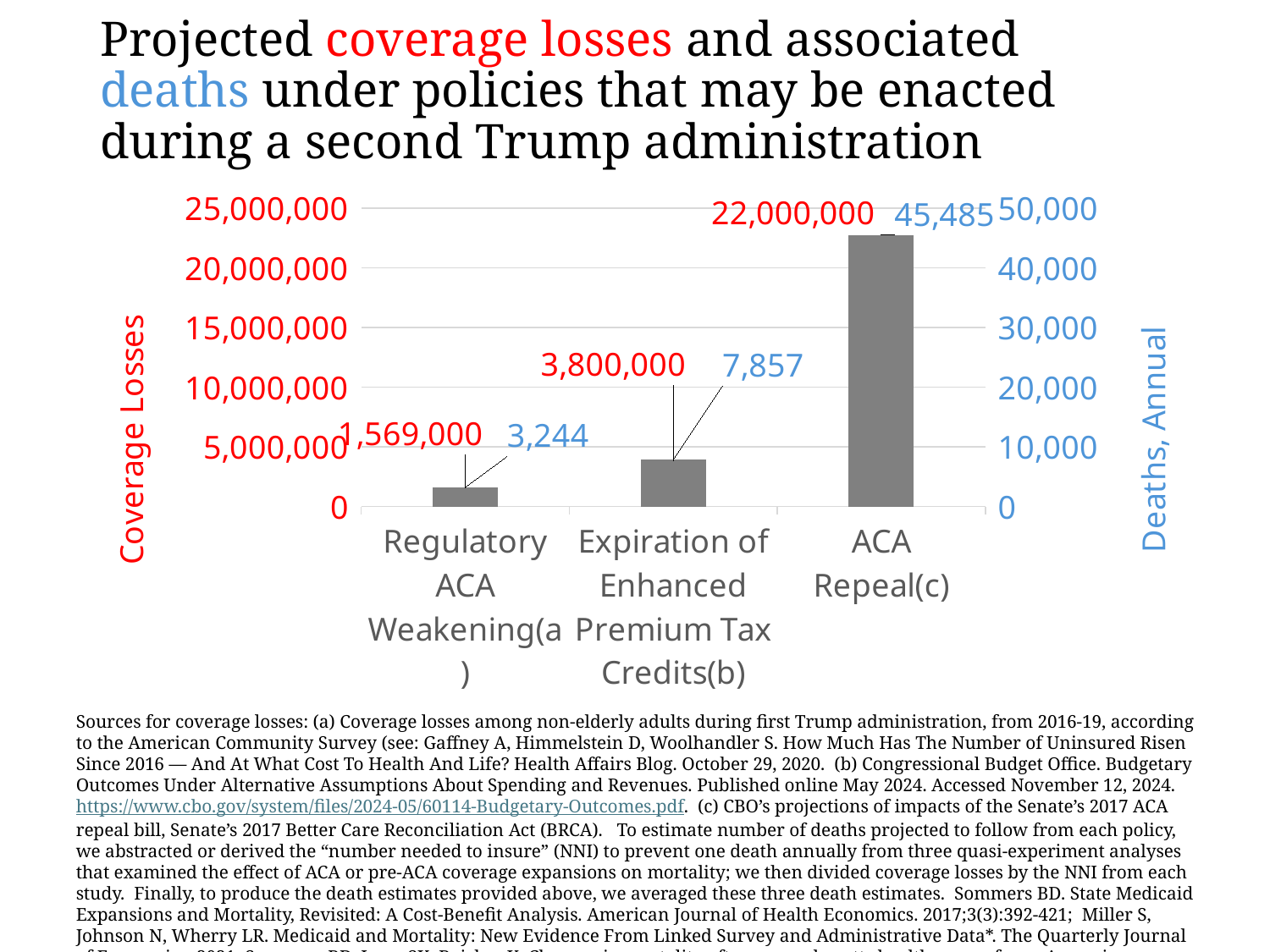
Which has larger projected coverage losses: Regulatory ACA Weakening(a) or Expiration of Enhanced Premium Tax Credits(b)? Expiration of Enhanced Premium Tax Credits(b) What is the label of the right-hand vertical axis? Deaths, Annual What is the projected annual number of deaths for Regulatory ACA Weakening(a)? 3,244 What is the projected annual number of deaths for ACA Repeal(c)? 45,485 What is the difference in projected annual deaths between Expiration of Enhanced Premium Tax Credits(b) and Regulatory ACA Weakening(a)? 4,613 How many policies are shown on the x axis of the chart? 3 What kind of chart is shown on the slide? Bar chart Which policy has the lowest projected annual deaths? Regulatory ACA Weakening(a) Which policy has the highest projected coverage losses? ACA Repeal(c) What is the projected coverage loss for Expiration of Enhanced Premium Tax Credits(b)? 3,800,000 What is the difference in projected coverage losses between ACA Repeal(c) and Expiration of Enhanced Premium Tax Credits(b)? 18,200,000 What is the projected coverage loss for ACA Repeal(c)? 22,000,000